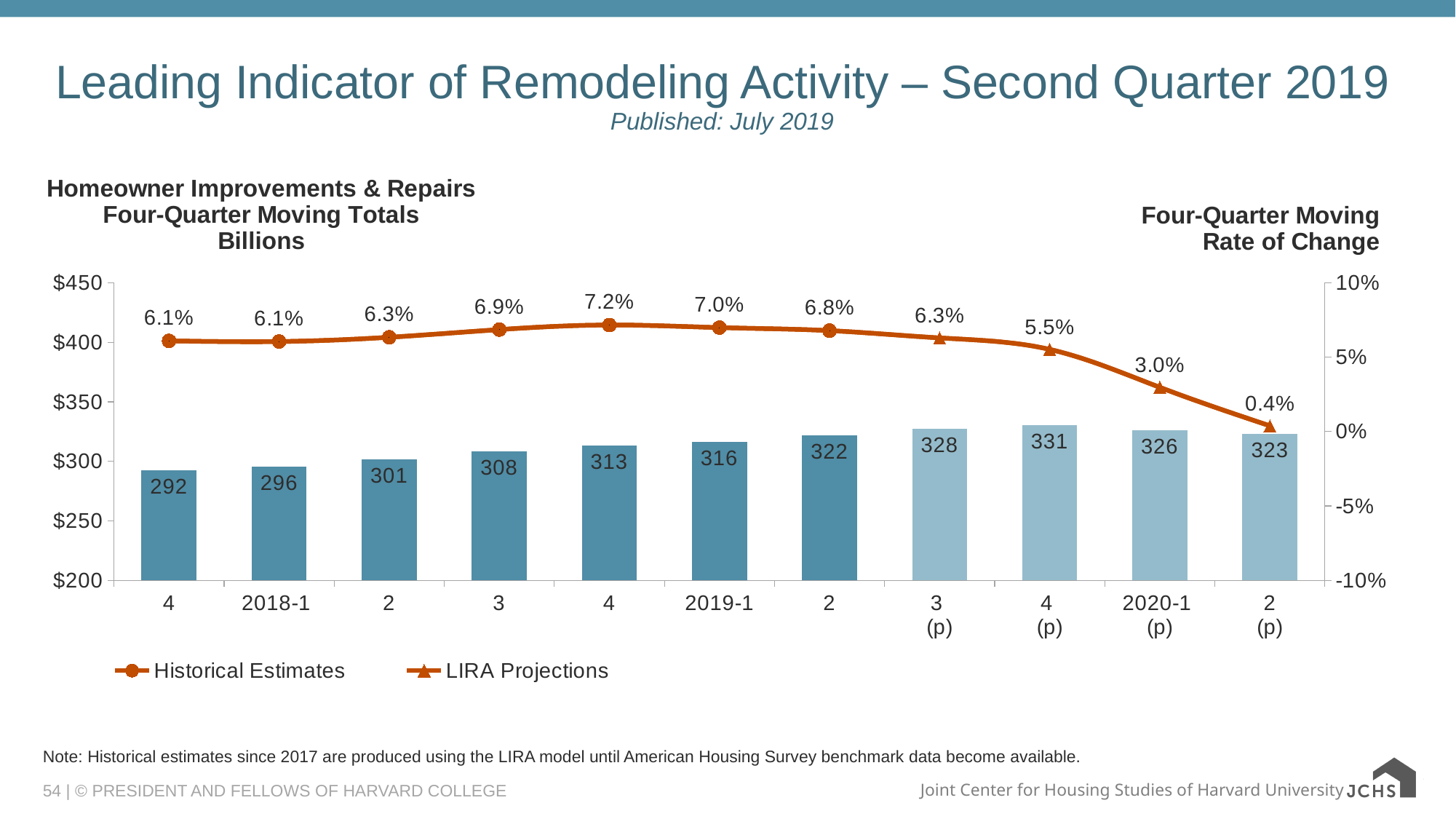
Which quarter has the lowest four-quarter moving rate of change on the line? 2 (p) How many quarters are shown on the x axis? 11 Which quarter has the highest four-quarter moving total bar? 4 (p) Does the rate of change line rise or fall from 4 (p) to 2 (p)? fall What is the four-quarter moving total (in billions) for 2019-1? 316 What is the difference between the four-quarter moving total for 2 (p) and for 2018-1? 27 How many series does the legend list? 2 What is the four-quarter moving rate of change shown for 2020-1 (p)? 3.0% What is the peak four-quarter moving rate of change shown on the line? 7.2% Which is larger, the rate of change for 2019-1 or for 3 (p)? 2019-1 What kind of chart is shown on the slide? Combined bar and line chart Is the four-quarter moving total bar for 2 (2019) greater or less than $300? greater